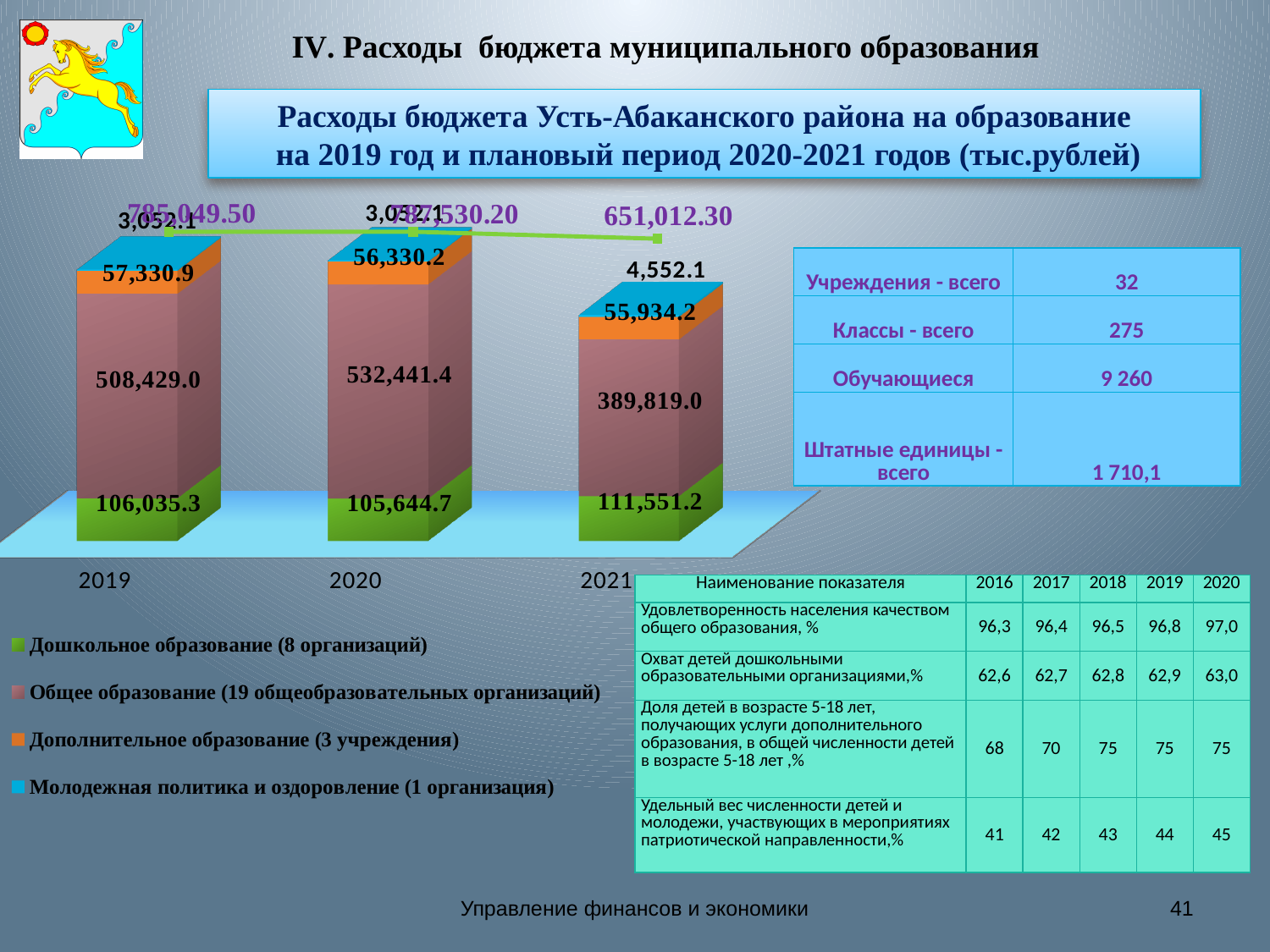
How many series does the chart legend list? 4 What is the value for Дополнительное образование in 2020? 56,330.2 Does the value for Дополнительное образование rise or fall from 2019 to 2021? fall What is the value for Дошкольное образование in 2021? 111,551.2 What is the value for Молодежная политика и оздоровление in 2021? 4,552.1 By how much does Дошкольное образование in 2021 exceed Дошкольное образование in 2020? 5,906.5 Which is larger: Дополнительное образование in 2019 or in 2021? 2019 What is the value for Общее образование in 2019? 508,429.0 In which year is the value for Общее образование the highest? 2020 What is the difference between Общее образование in 2020 and in 2019? 24,012.4 How many years are shown on the x axis of the chart? 3 In which year is the value for Общее образование the lowest? 2021